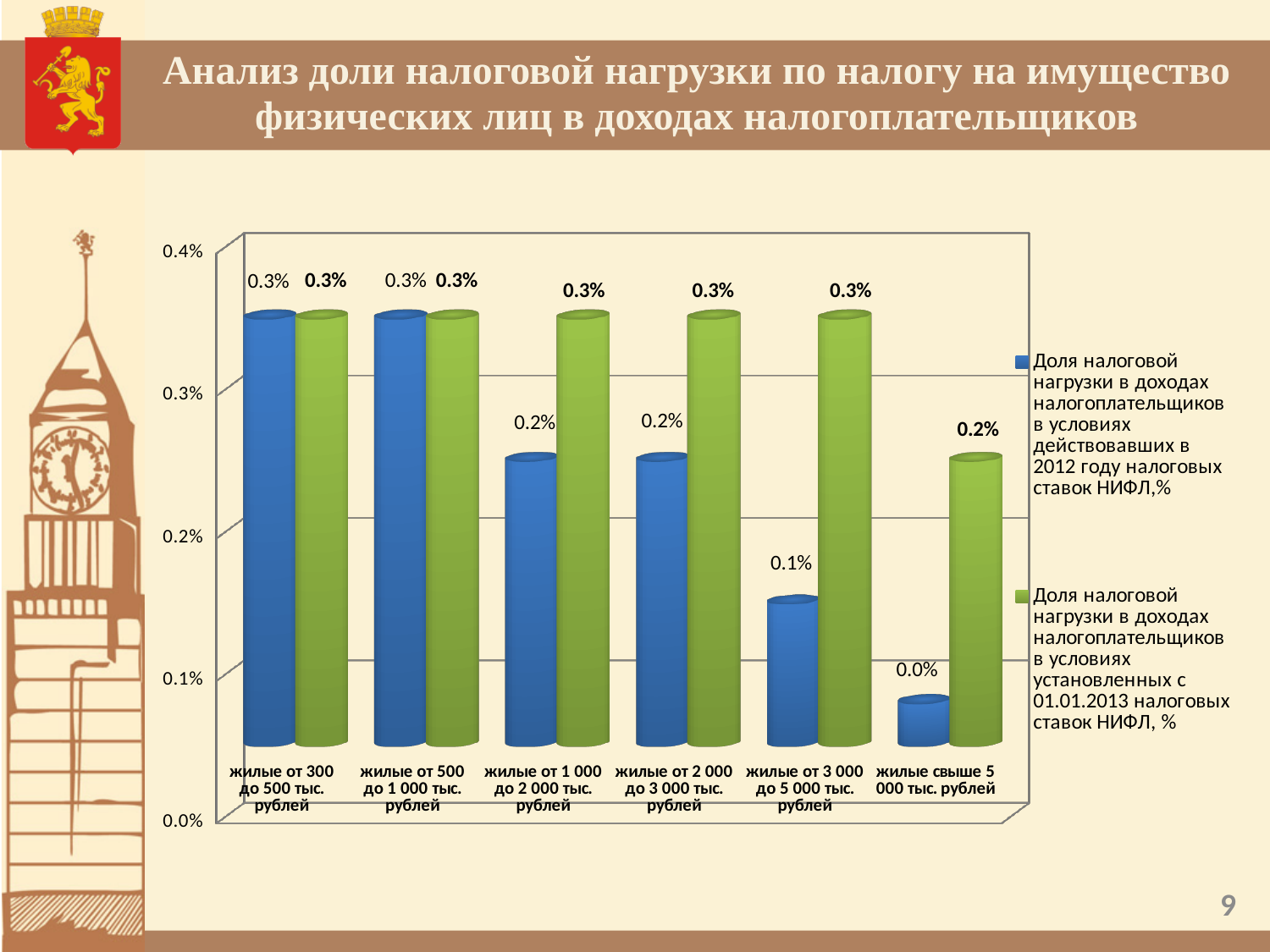
What kind of chart is shown on the slide? bar chart What is the value for "жилые от 3 000 до 5 000 тыс. рублей" under the 2012 tax rates (blue series)? 0.1% For "жилые от 3 000 до 5 000 тыс. рублей", which series has the larger value: the 2012 rates (blue) or the 2013 rates (green)? 2013 rates (green) Do the values of the blue (2012 rates) series rise or fall moving from left to right along the x axis? fall Which category has the lowest value in the green (2013 rates) series? жилые свыше 5 000 тыс. рублей What is the value for "жилые свыше 5 000 тыс. рублей" under the 2012 tax rates (blue series)? 0.0% How many series does the legend list? 2 What is the value for "жилые от 1 000 до 2 000 тыс. рублей" under the 2012 tax rates (blue series)? 0.2% Which category has the lowest value in the blue (2012 rates) series? жилые свыше 5 000 тыс. рублей How many housing value categories are shown on the x axis? 6 Is the blue (2012 rates) bar for "жилые от 3 000 до 5 000 тыс. рублей" greater or less than 0.2%? less What is the value for "жилые свыше 5 000 тыс. рублей" under the tax rates set from 01.01.2013 (green series)? 0.2%